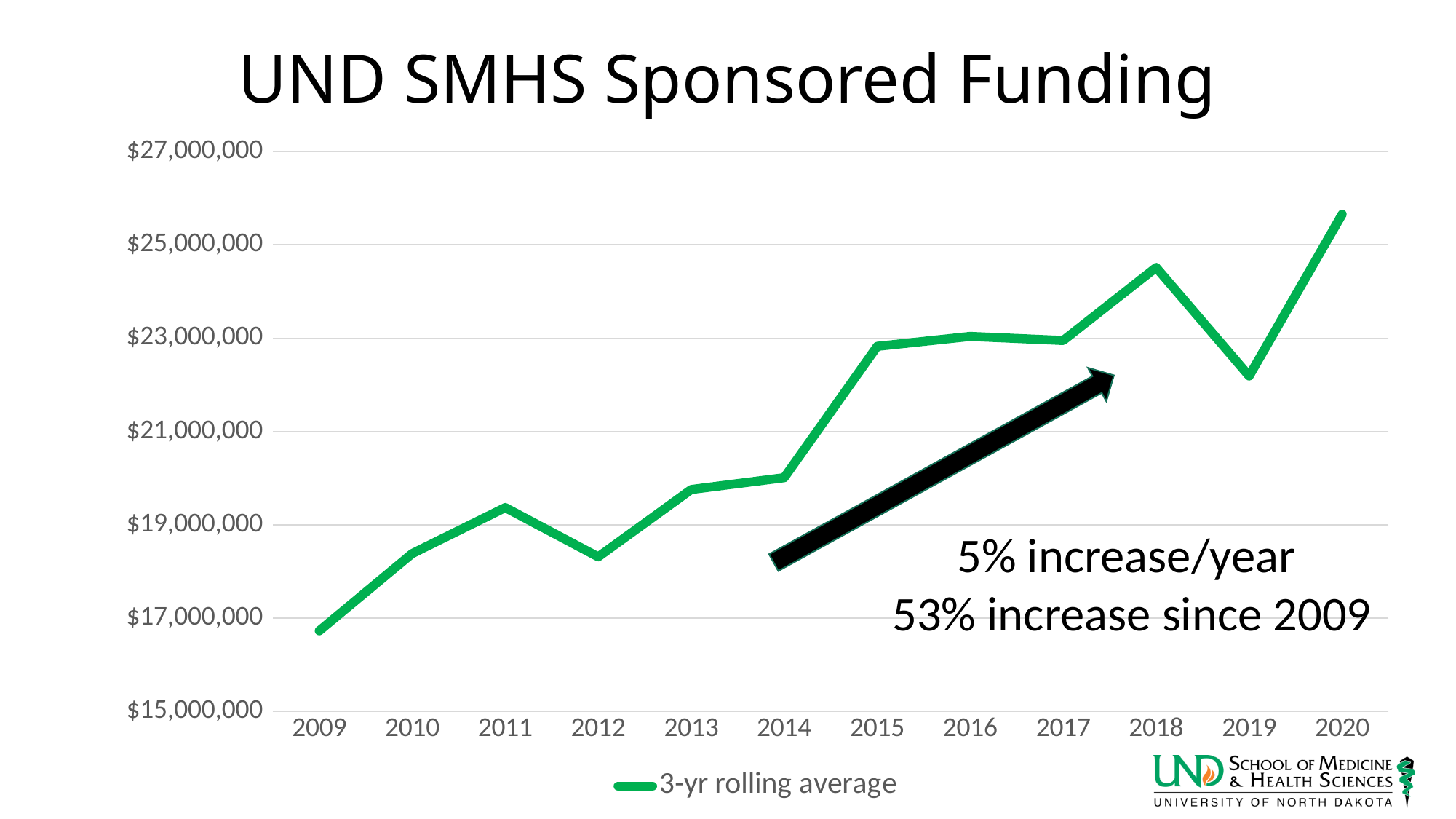
What is the title of the chart? UND SMHS Sponsored Funding Is the value for 2009 greater or less than $17,000,000? less Which year has the highest 3-yr rolling average? 2020 How many years are plotted on the x axis? 12 What kind of chart is shown on the slide? line chart Is the value for 2012 greater or less than $19,000,000? less Overall, does the 3-yr rolling average rise or fall from 2009 to 2020? rise Which year has the lowest 3-yr rolling average? 2009 Which year has the larger 3-yr rolling average, 2018 or 2019? 2018 How many series does the legend list? 1 What series does the legend list? 3-yr rolling average Is the value for 2020 greater or less than $25,000,000? greater